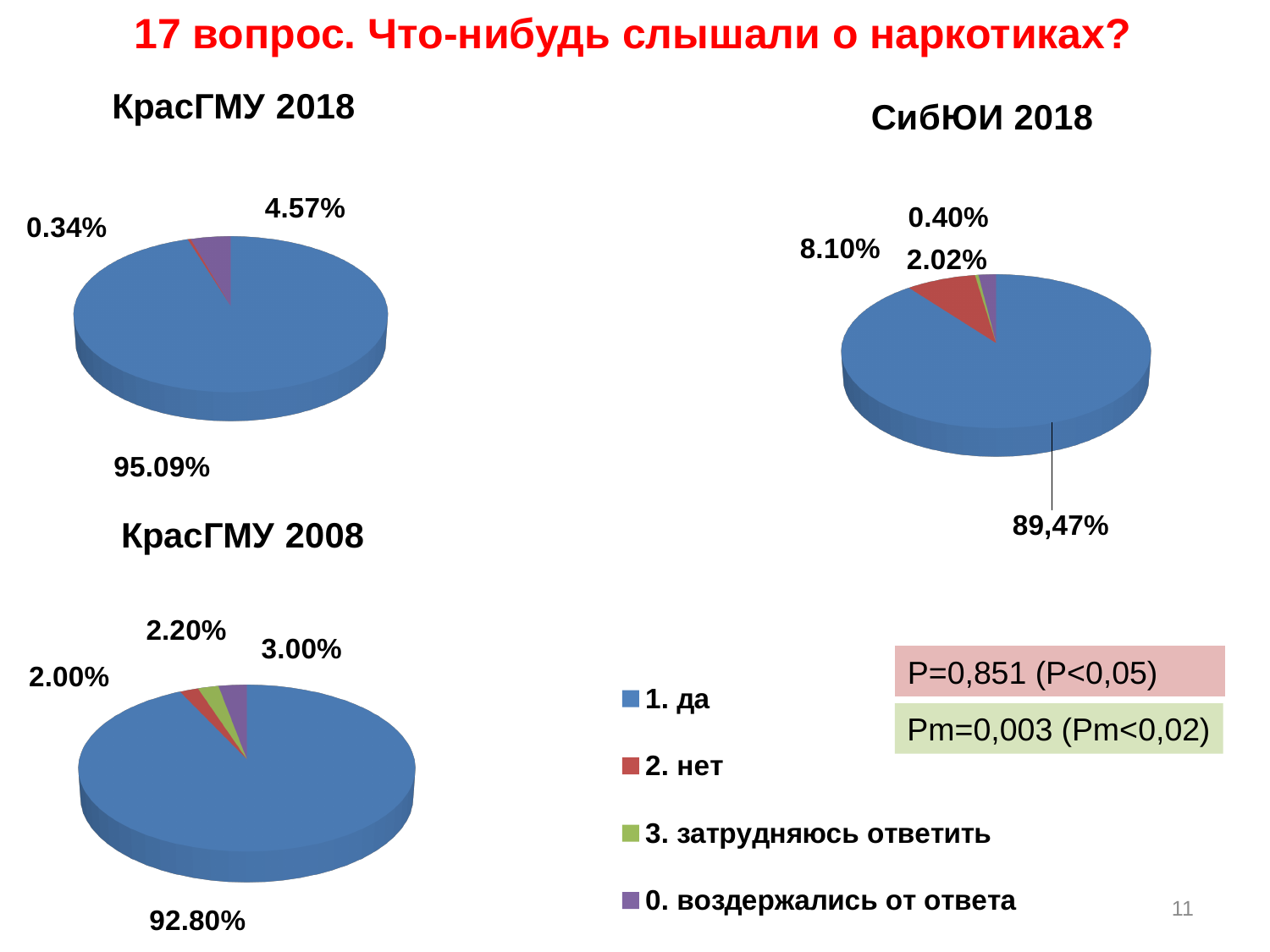
In the КрасГМУ 2008 pie chart, what is the difference between the "3. затрудняюсь ответить" share and the "2. нет" share? 0.20% In the СибЮИ 2018 pie chart, what is the smallest labelled value? 0.40% In the КрасГМУ 2008 pie chart, what share of respondents answered "0. воздержались от ответа"? 3.00% In the СибЮИ 2018 pie chart, what share of respondents answered "2. нет"? 8.10% In the КрасГМУ 2018 pie chart, what share of respondents answered "1. да"? 95.09% Which chart shows a larger share for "1. да": КрасГМУ 2018 or СибЮИ 2018? КрасГМУ 2018 In the КрасГМУ 2018 pie chart, what is the largest labelled value? 95.09% In the СибЮИ 2018 pie chart, what share of respondents answered "1. да"? 89,47% How many pie charts are shown on the slide? 3 In the КрасГМУ 2008 pie chart, what share of respondents answered "1. да"? 92.80% In the КрасГМУ 2018 pie chart, what is the smallest labelled value? 0.34% How many entries does the legend list? 4